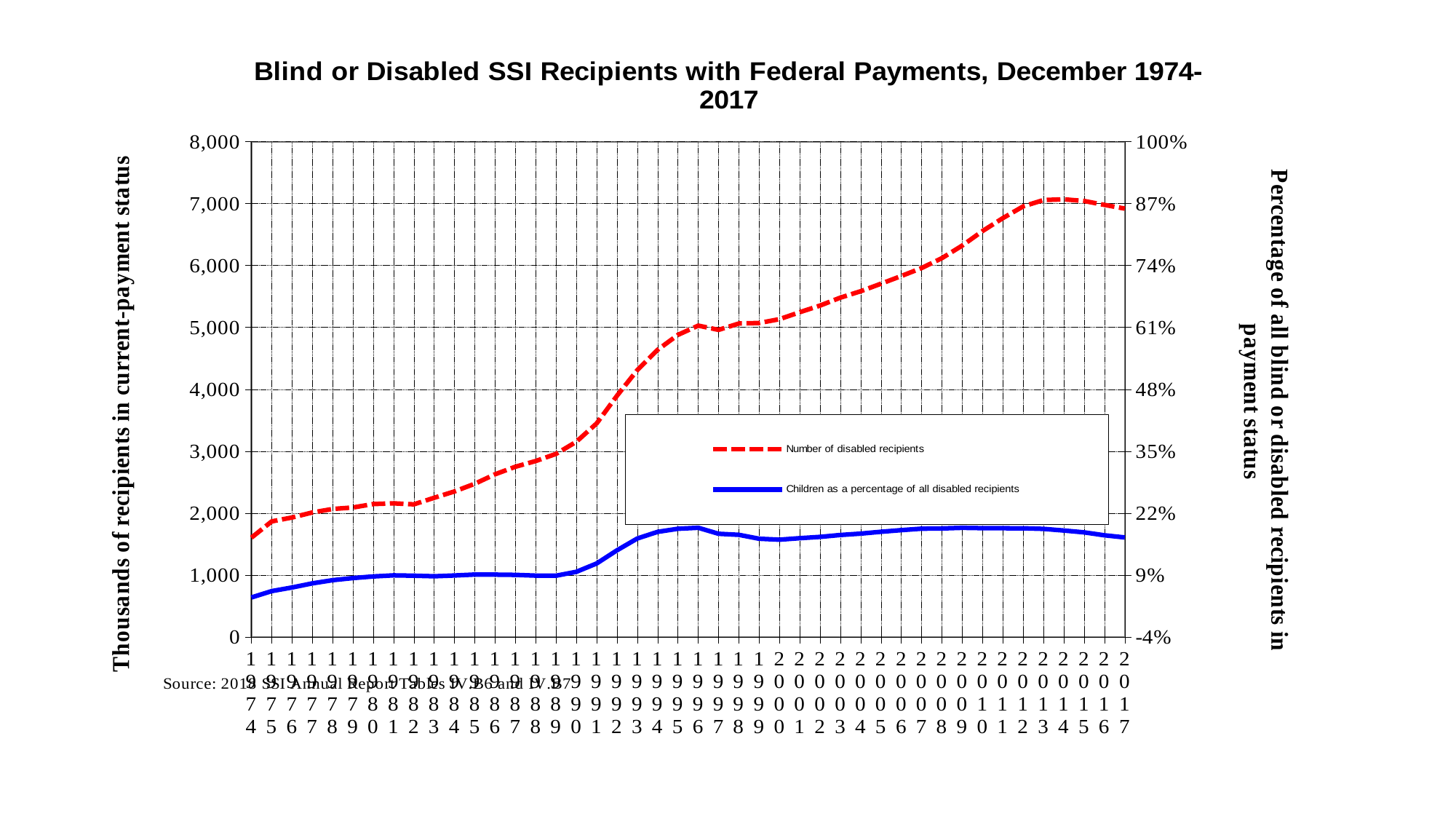
What kind of chart is shown on the slide? line chart Is the number of disabled recipients in 2017 greater or less than 6,000? greater Is the value for children as a percentage of all disabled recipients in 1974 greater or less than 9%? less Is the number of disabled recipients in 1974 greater or less than 2,000? less What is the title of the chart? Blind or Disabled SSI Recipients with Federal Payments, December 1974-2017 How many years are plotted along the x axis? 44 Which series is drawn as a red dashed line? Number of disabled recipients In which year is the number of disabled recipients lowest? 1974 How many series does the legend list? 2 Does the number of disabled recipients generally rise or fall from 1974 to 2017? rise Which is larger, the number of disabled recipients in 2017 or in 1974? 2017